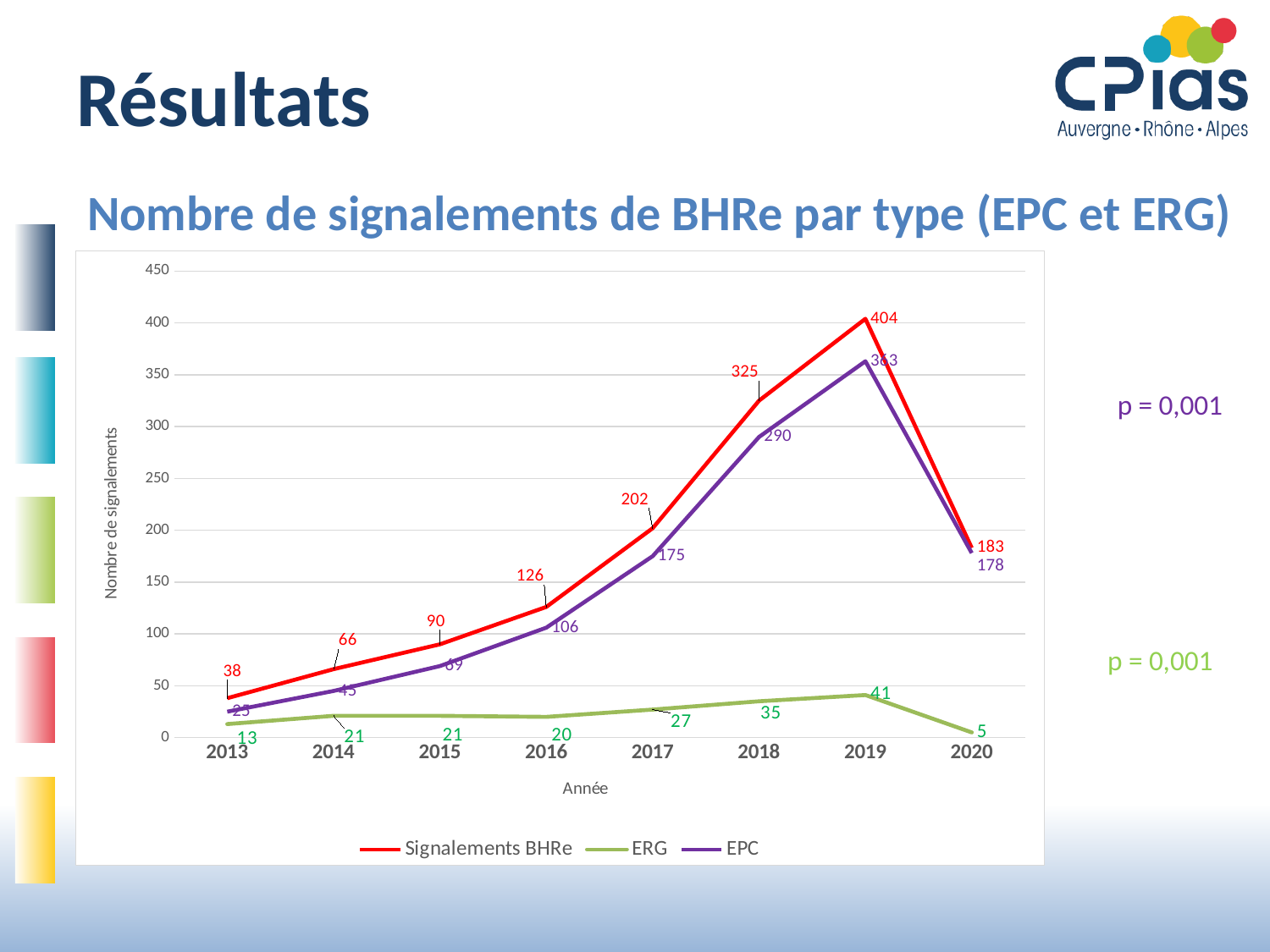
Which is larger in 2017: EPC or ERG? EPC How many years are shown on the x axis? 8 What is the title of the chart? Nombre de signalements de BHRe par type (EPC et ERG) In which year is the Signalements BHRe series highest? 2019 What is the difference between Signalements BHRe in 2019 and in 2020? 221 What is the value of ERG in 2020? 5 What is the value of EPC in 2018? 290 Does the Signalements BHRe series rise or fall from 2013 to 2019? rise What is the value of Signalements BHRe in 2019? 404 How many series does the legend list? 3 What type of chart is shown on the slide? line chart In which year is the ERG series lowest? 2020